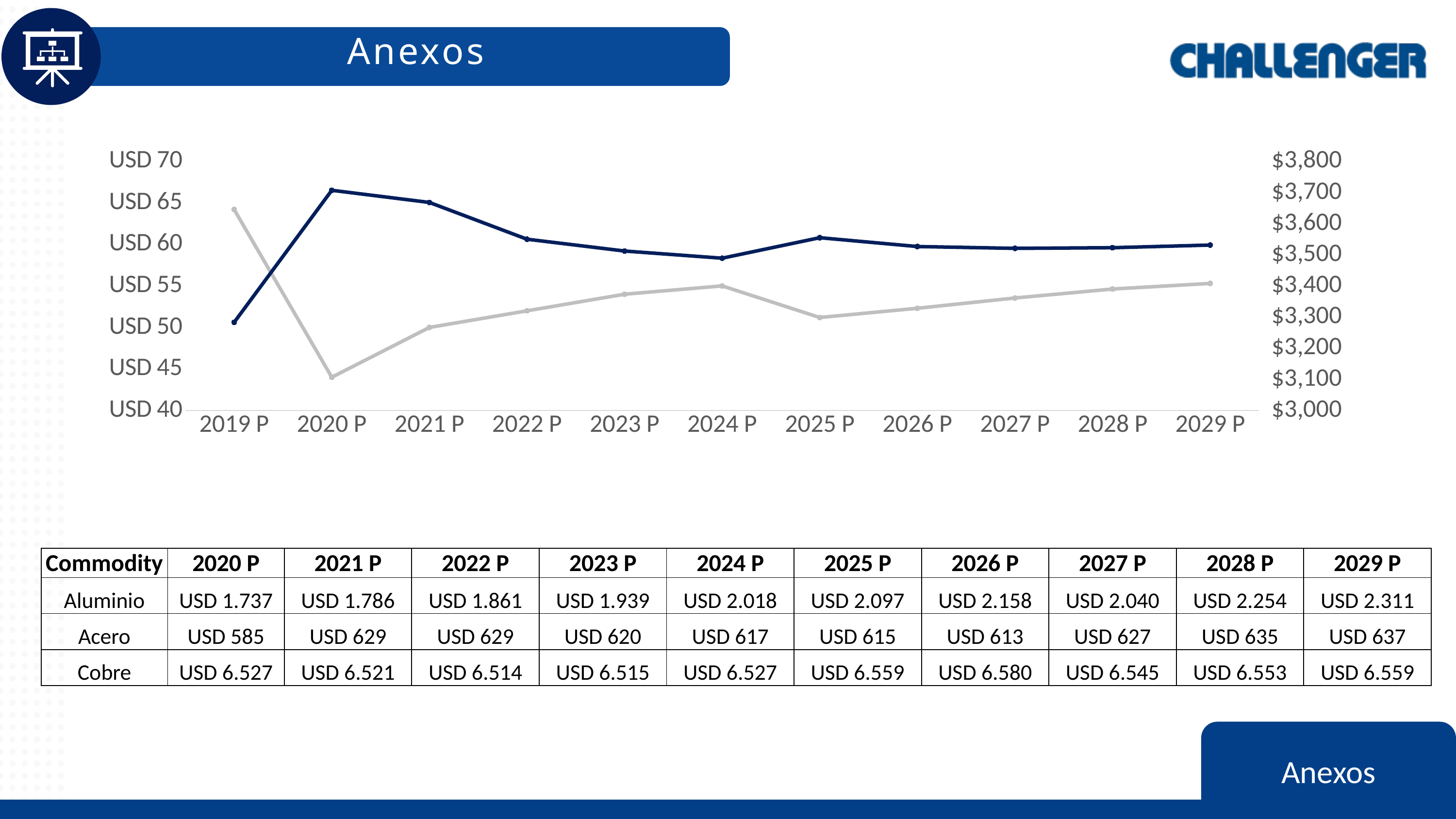
In which year is the grey line at its highest point? 2019 P At 2019 P, which line is higher on the chart, the dark blue line or the grey line? grey line Does the dark blue line rise or fall from 2020 P to 2024 P? fall In which year does the dark blue line reach its highest point? 2020 P How many points along the x axis does the chart have? 11 What is the highest tick label on the right-hand axis of the chart? $3,800 Does the grey line rise or fall from 2020 P to 2024 P? rise In which year is the dark blue line at its lowest point? 2019 P At 2020 P, which line is higher on the chart, the dark blue line or the grey line? dark blue line In which year does the grey line reach its lowest point? 2020 P What kind of chart is shown on the slide? line chart How many lines are plotted on the chart? 2